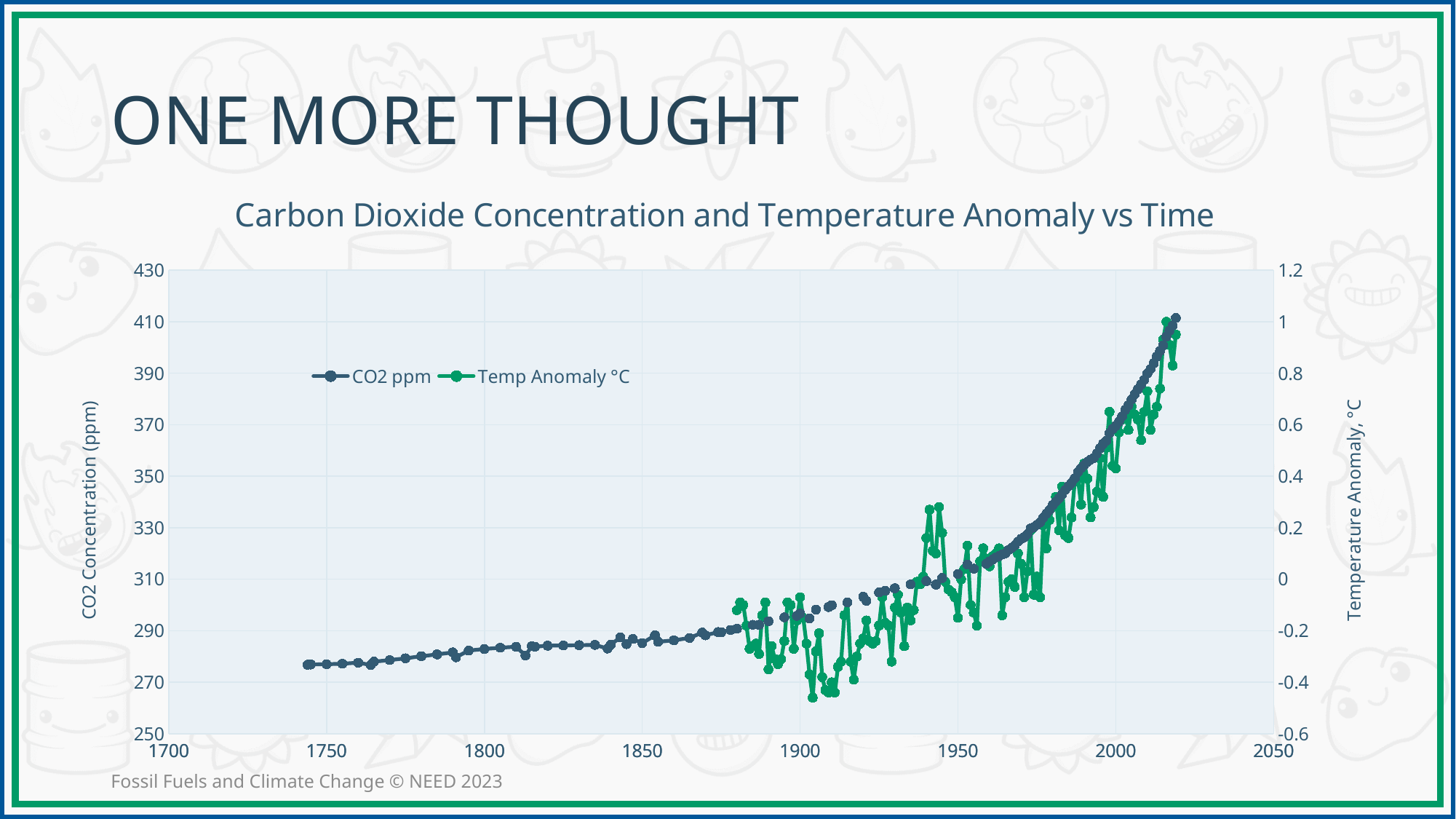
Which is larger, the CO2 ppm value around the year 2000 or around the year 1900? Around 2000 Is the CO2 ppm value around the year 2000 greater or less than 350? greater What is the title of the chart? Carbon Dioxide Concentration and Temperature Anomaly vs Time Is the CO2 ppm value around the year 1750 greater or less than 290? less How many series does the chart's legend list? 2 What are the two series named in the legend? CO2 ppm and Temp Anomaly °C What kind of chart is shown on the slide? Line chart Does the CO2 ppm series rise or fall as the years increase along the x axis? Rise Is the Temp Anomaly °C value around the year 1900 greater or less than 0? less Which is larger, the Temp Anomaly °C value around the year 2010 or around the year 1910? Around 2010